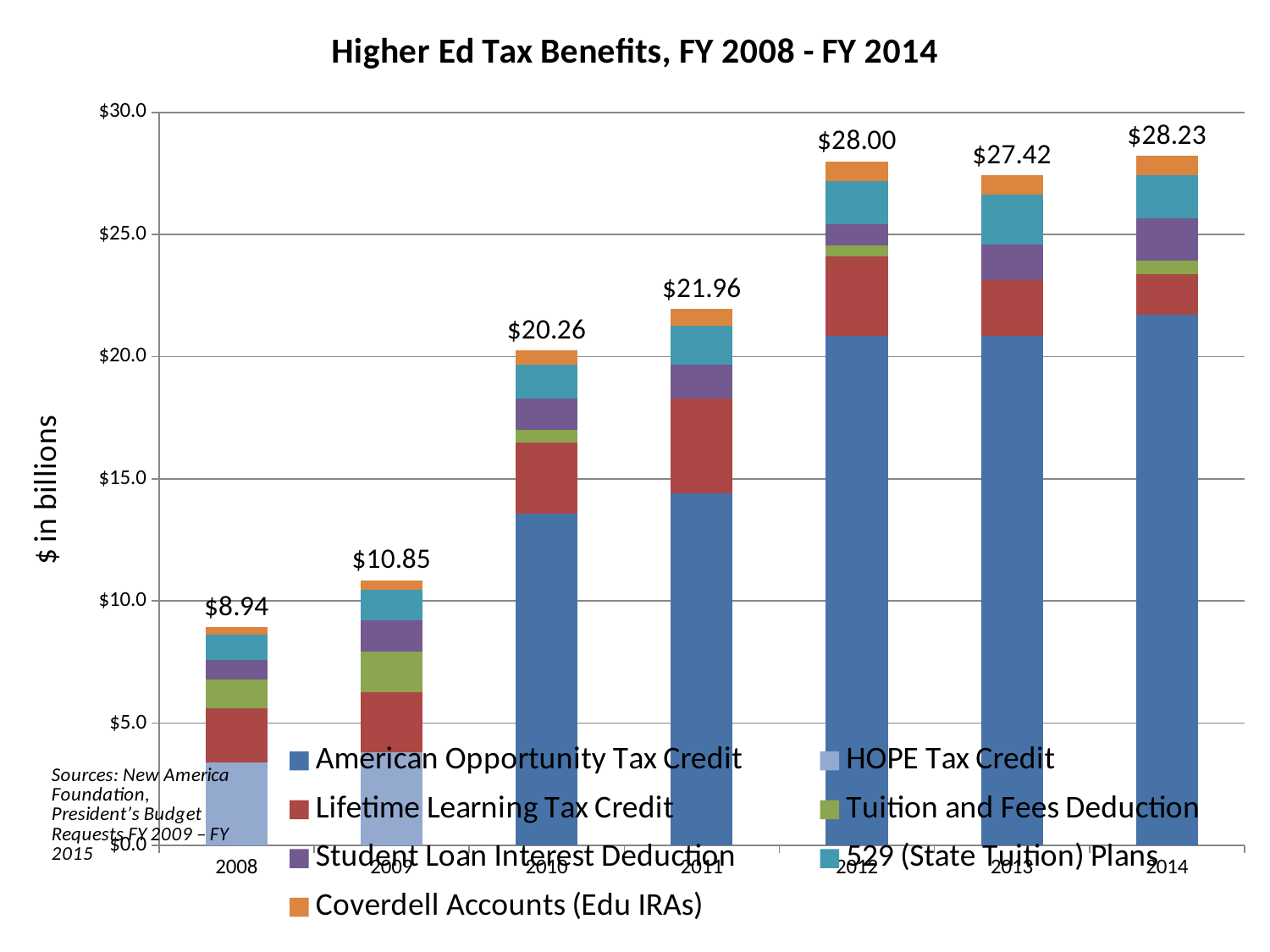
What kind of chart is shown on the slide? Stacked bar chart Is the American Opportunity Tax Credit value for 2014 greater or less than $20.0? greater What is the total value of the stacked bar for 2012? $28.00 Which year has a larger total, 2012 or 2013? 2012 Which year has the highest total higher ed tax benefits? 2014 How many series does the legend list? 7 What is the difference between the total for 2014 and the total for 2013? $0.81 What is the total value of the stacked bar for 2010? $20.26 What is the difference between the total for 2011 and the total for 2010? $1.70 How many years are shown on the x axis? 7 What is the total value of the stacked bar for 2008? $8.94 Which year has the lowest total higher ed tax benefits? 2008